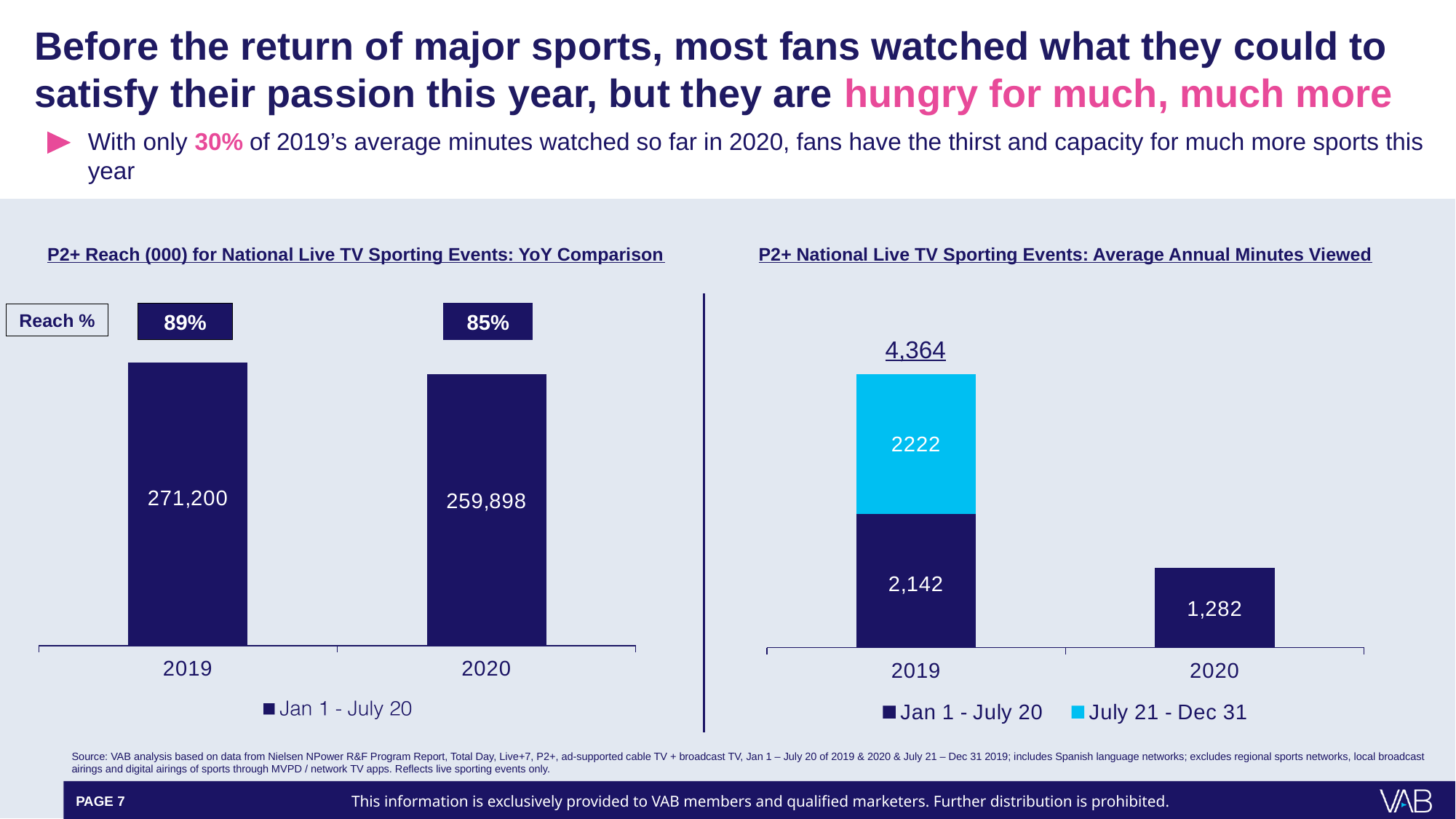
In the P2+ Reach (000) chart, which year has the higher reach? 2019 In the Average Annual Minutes Viewed chart, what is the July 21 - Dec 31 value for 2019? 2222 In the P2+ Reach (000) chart, what is the value for 2019? 271,200 In the P2+ Reach (000) chart, what is the difference between the 2019 and 2020 values? 11,302 In the Average Annual Minutes Viewed chart, what is the difference between the Jan 1 - July 20 values for 2019 and 2020? 860 What kind of chart is the Average Annual Minutes Viewed chart? Stacked bar chart In the P2+ Reach (000) chart, what Reach % is shown above the 2020 bar? 85% In the Average Annual Minutes Viewed chart, what is the Jan 1 - July 20 value for 2019? 2,142 In the P2+ Reach (000) chart, what is the value for 2020? 259,898 In the Average Annual Minutes Viewed chart, what is the value for 2020? 1,282 In the P2+ Reach (000) chart, how many series does the legend list? 1 In the Average Annual Minutes Viewed chart, what is the total of the stacked 2019 bar? 4,364